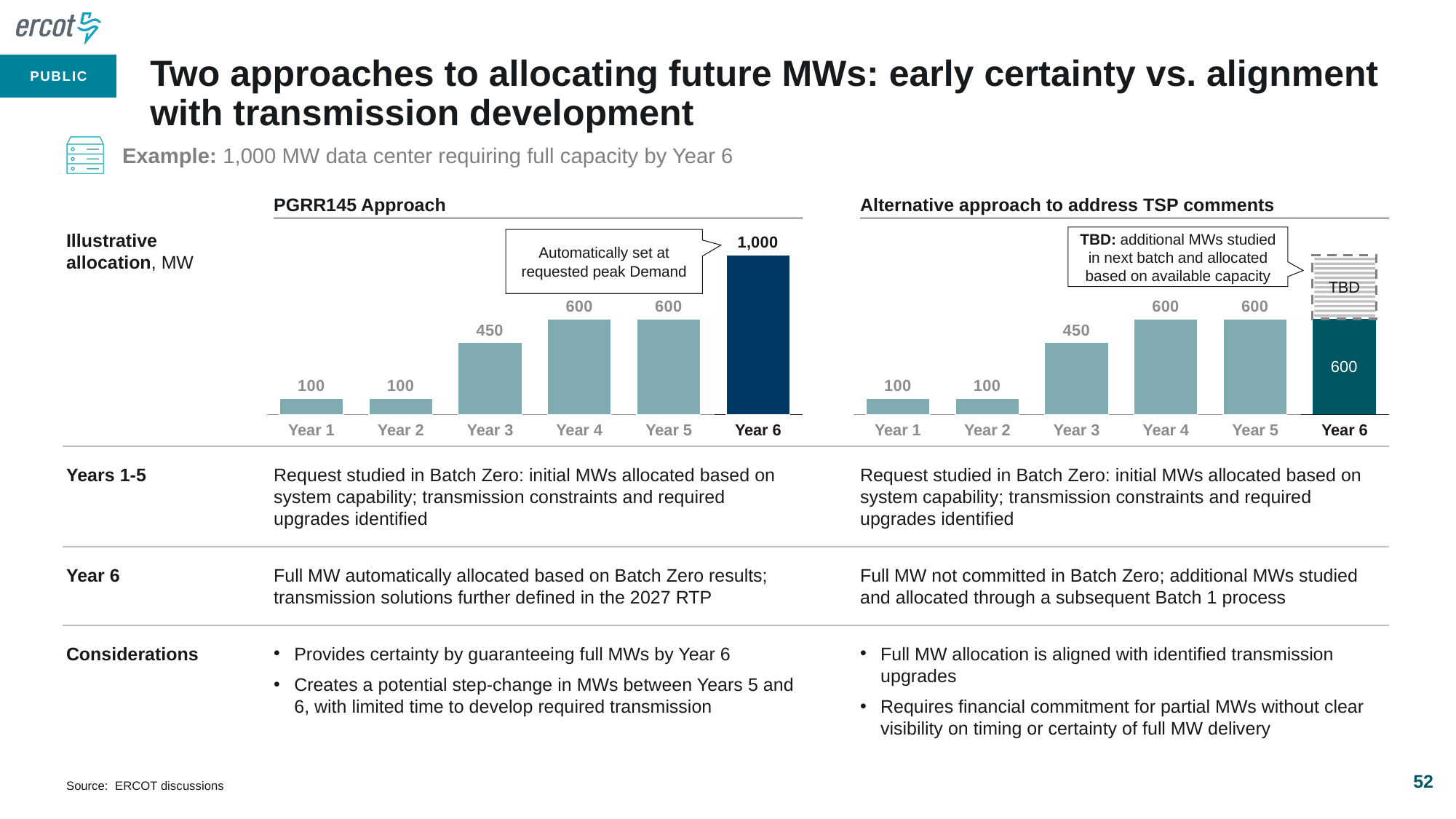
In the PGRR145 Approach chart, what is the difference between the Year 3 and Year 2 values? 350 What type of chart is the Alternative approach to address TSP comments chart? Bar chart In the Alternative approach to address TSP comments chart, what is the labelled value of the solid portion of the Year 6 bar? 600 In the PGRR145 Approach chart, what is the value for Year 6? 1,000 What unit is given for the illustrative allocation shown in the charts? MW In the PGRR145 Approach chart, do the values rise or fall from Year 1 to Year 6? Rise In the Alternative approach to address TSP comments chart, which is larger, the value for Year 3 or the value for Year 4? Year 4 In the Alternative approach to address TSP comments chart, what label is shown on the hatched portion of the Year 6 bar? TBD How many years are shown on the x axis of the PGRR145 Approach chart? 6 In the PGRR145 Approach chart, which year has the highest value? Year 6 In the PGRR145 Approach chart, what is the difference between the Year 6 and Year 5 values? 400 In the PGRR145 Approach chart, what is the value for Year 3? 450